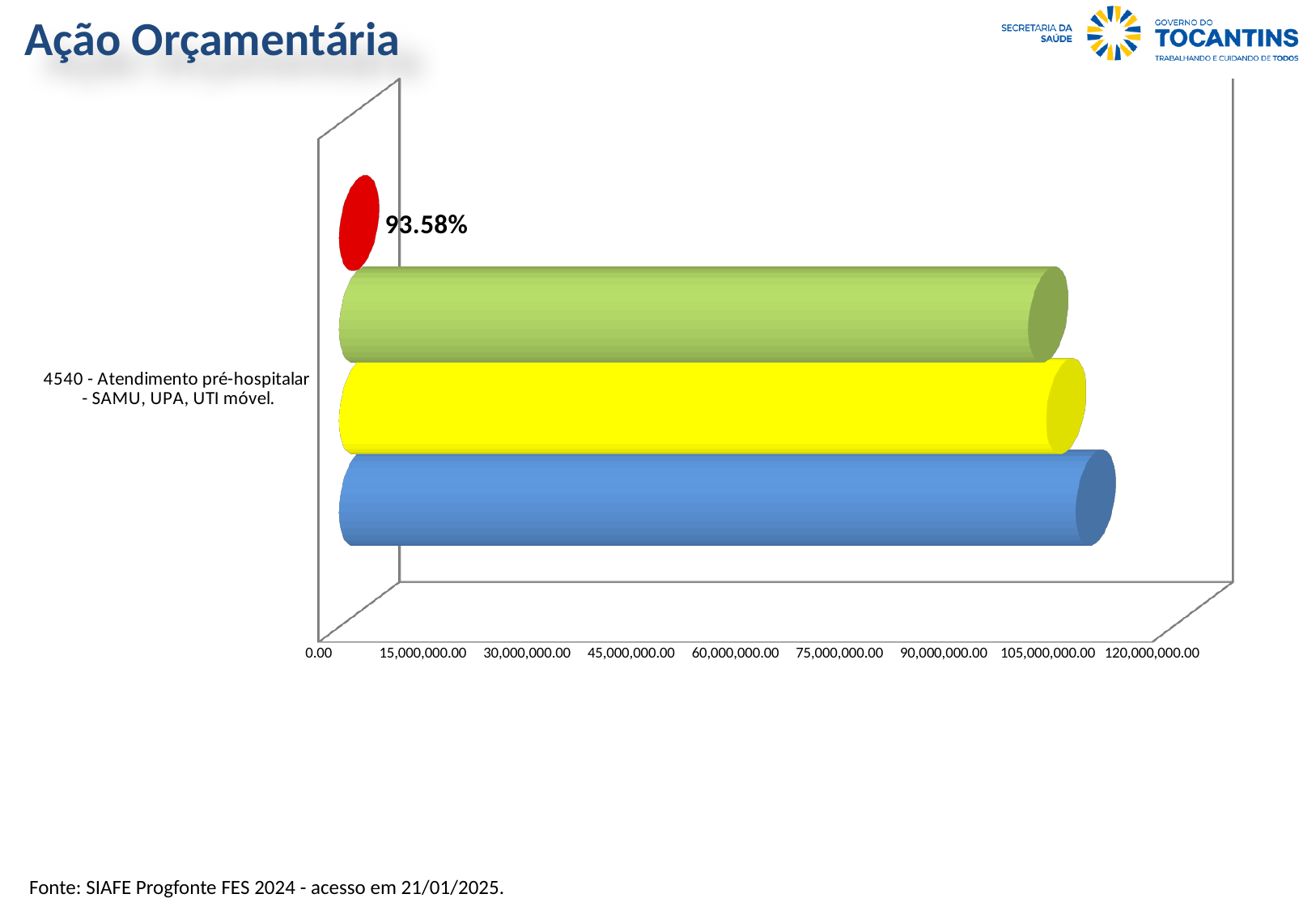
How many bars are plotted in the chart? 4 Is the value of the red bar greater or less than 15,000,000.00? less Is the value of the green bar greater or less than 90,000,000.00? greater What is the category label shown on the chart? 4540 - Atendimento pré-hospitalar - SAMU, UPA, UTI móvel. Is the value of the blue bar greater or less than 105,000,000.00? greater How many categories are shown on the vertical axis of the chart? 1 What is the highest value shown on the horizontal axis? 120,000,000.00 Which is larger, the blue bar or the green bar? blue bar Which coloured bar is the shortest in the chart? red What kind of chart is shown on the slide? bar chart Which coloured bar is the longest in the chart? blue What value is printed as a data label next to the red bar? 93.58%